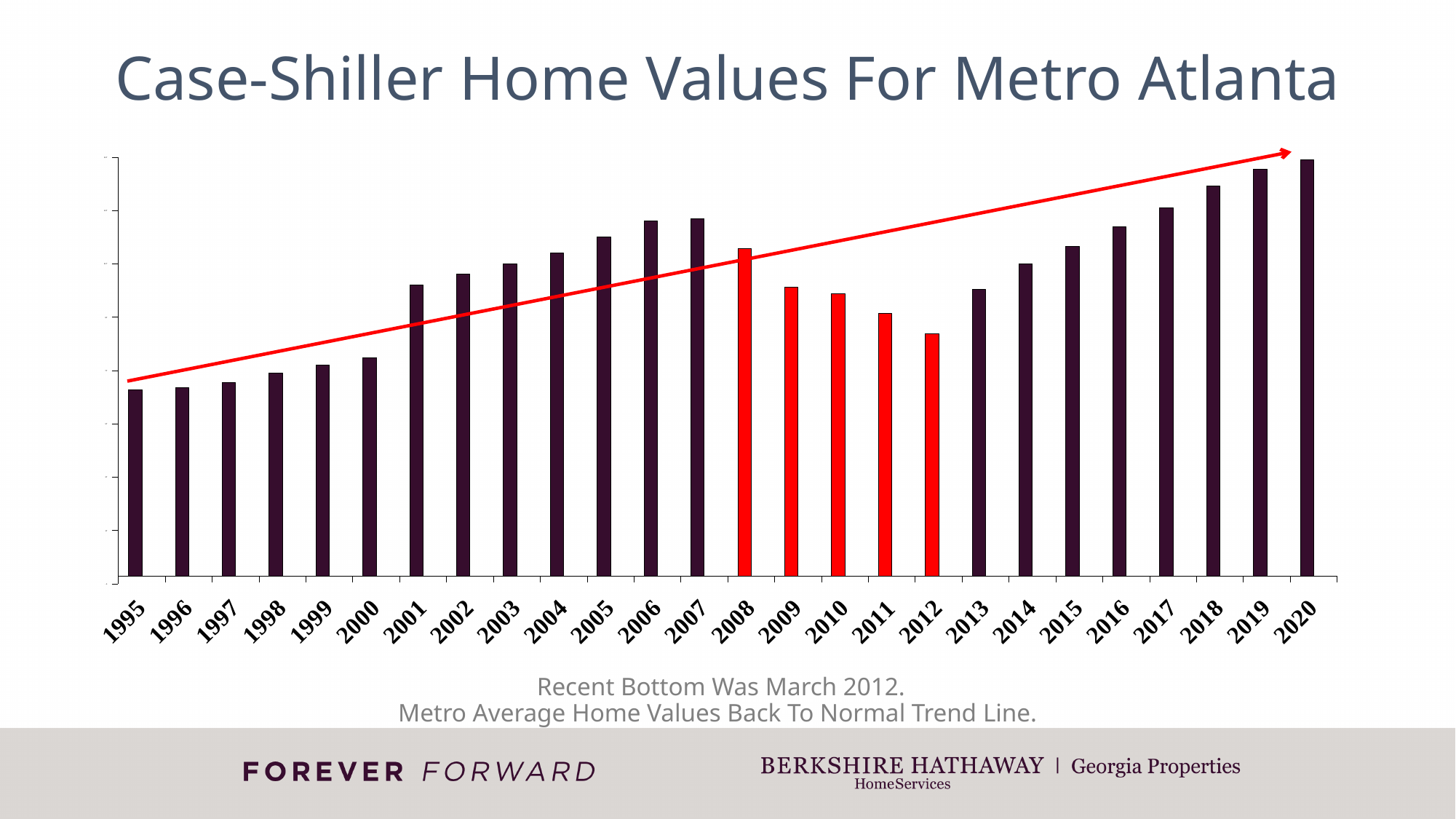
Which year has the highest home value on the chart? 2020 Which year has the higher value, 2013 or 2012? 2013 Which year has the higher value, 2020 or 2007? 2020 Do the values rise or fall from 2008 to 2012? Fall Which years are shown with red bars? 2008 to 2012 Do the values rise or fall from 2012 to 2020? Rise Among the red-highlighted bars, which year has the lowest value? 2012 What is the title of the chart? Case-Shiller Home Values For Metro Atlanta Do the values rise or fall from 1995 to 2007? Rise How many years (bars) are plotted on the chart? 26 What kind of chart is shown on the slide? Bar chart Which year has the higher value, 2007 or 2012? 2007